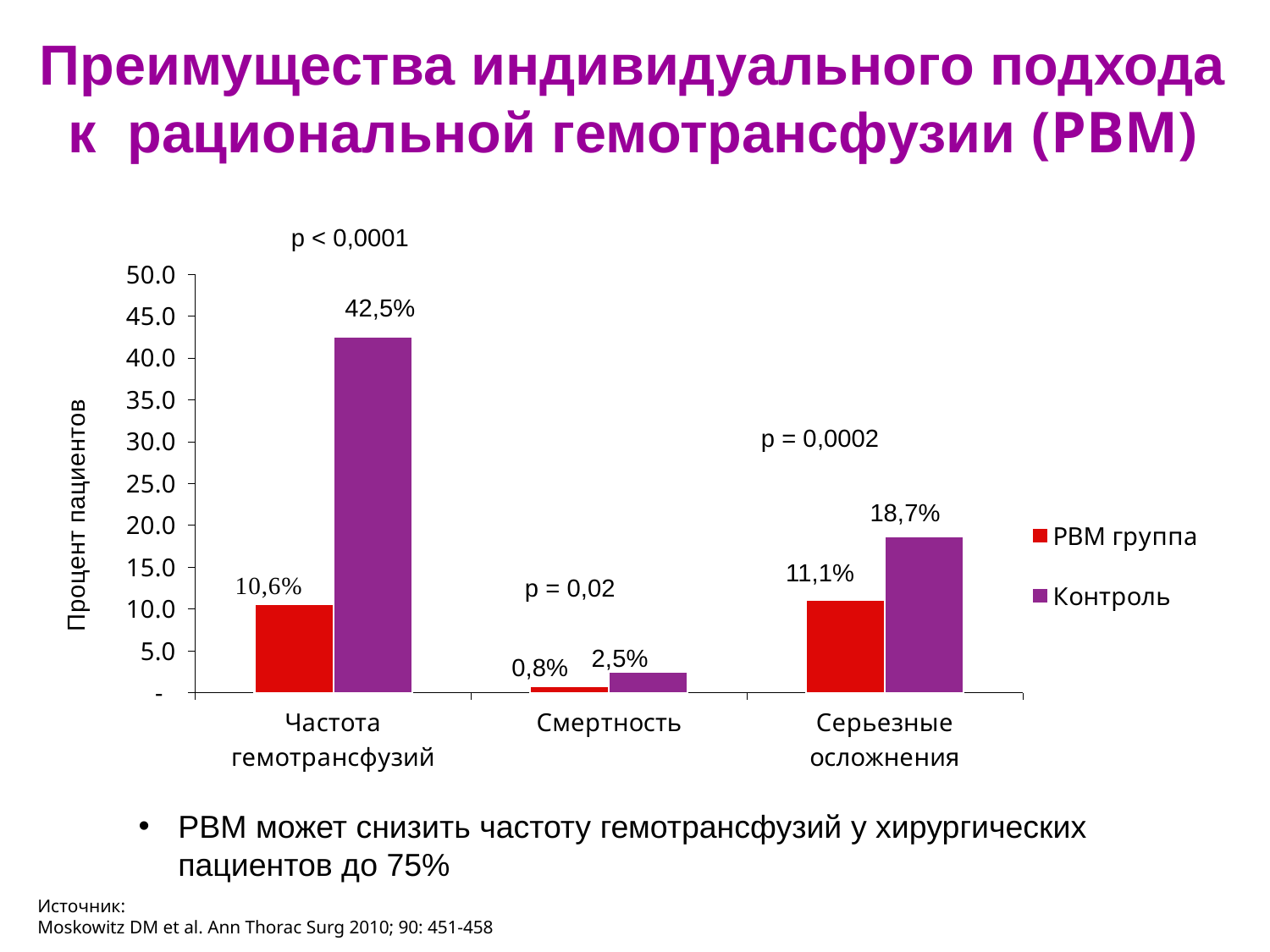
What is the difference between the Контроль and PBM группа values in the Частота гемотрансфузий category? 31,9% What is the value for the Контроль series in the Смертность category? 2,5% What type of chart is shown on the slide? Bar chart In which category does the Контроль series reach its highest value? Частота гемотрансфузий How many categories are shown on the x axis of the chart? 3 In which category does the PBM группа series have its lowest value? Смертность Which is larger in the Серьезные осложнения category: the PBM группа value or the Контроль value? Контроль What is the value for the Контроль series in the Частота гемотрансфузий category? 42,5% What is the value for the PBM группа series in the Серьезные осложнения category? 11,1% What is the value for the PBM группа series in the Смертность category? 0,8% What is the difference between the Контроль and PBM группа values in the Серьезные осложнения category? 7,6% How many series does the chart legend list? 2